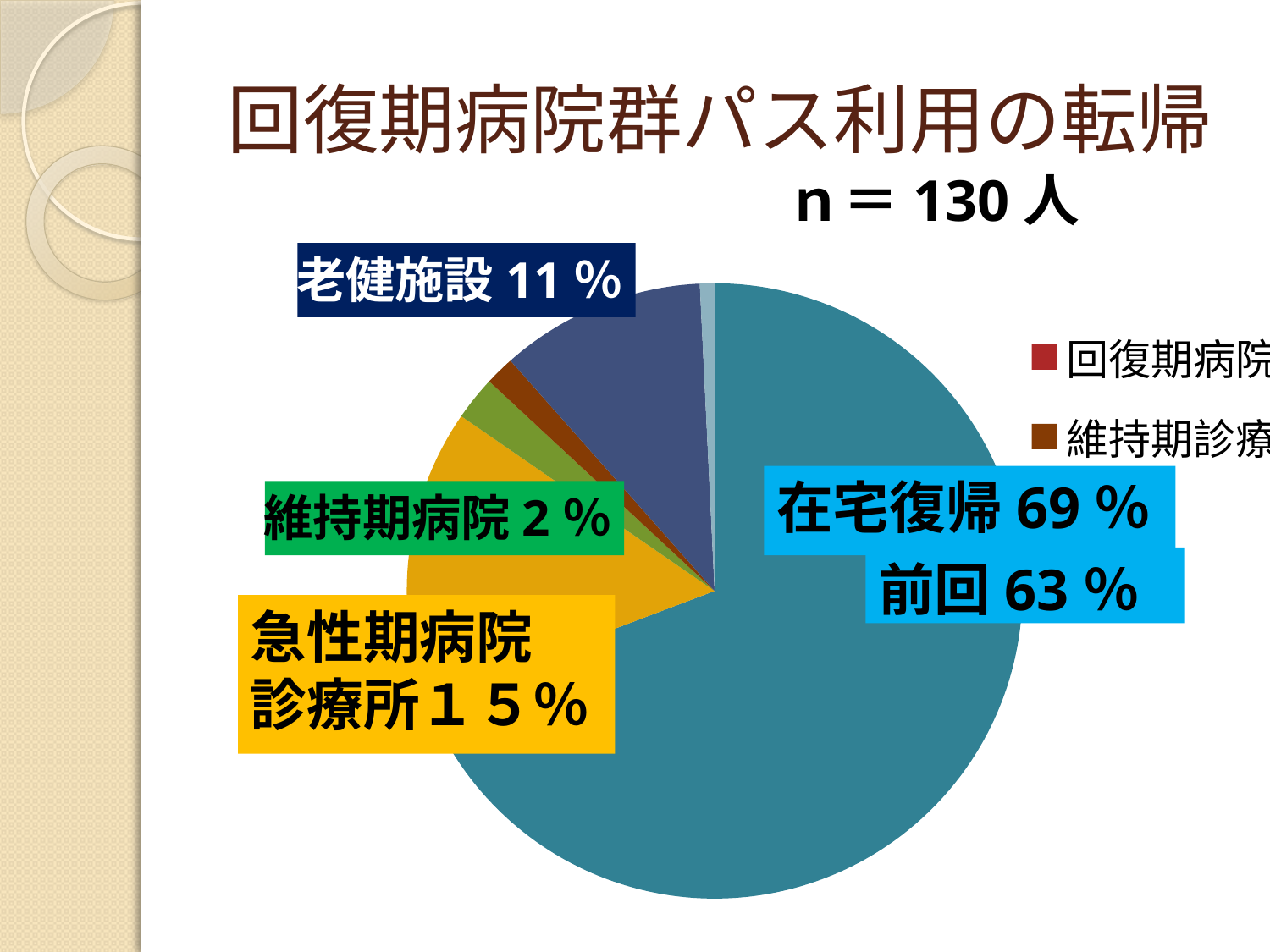
Which labelled category has the smallest share of the pie? 維持期病院 Which is larger, the share for 老健施設 or the share for 急性期病院診療所? 急性期病院診療所 What percentage of the pie is labelled 在宅復帰? 69% By how many percentage points did 在宅復帰 increase from the previous (前回) value to the current value? 6 What percentage is labelled 老健施設? 11% What is the title of the chart on the slide? 回復期病院群パス利用の転帰 What is the sample size (n) shown on the slide? 130人 Which labelled category has the largest share of the pie? 在宅復帰 What was the previous (前回) percentage for 在宅復帰? 63% What kind of chart is shown on the slide? pie chart What percentage is labelled 急性期病院診療所? 15% What percentage is labelled 維持期病院? 2%